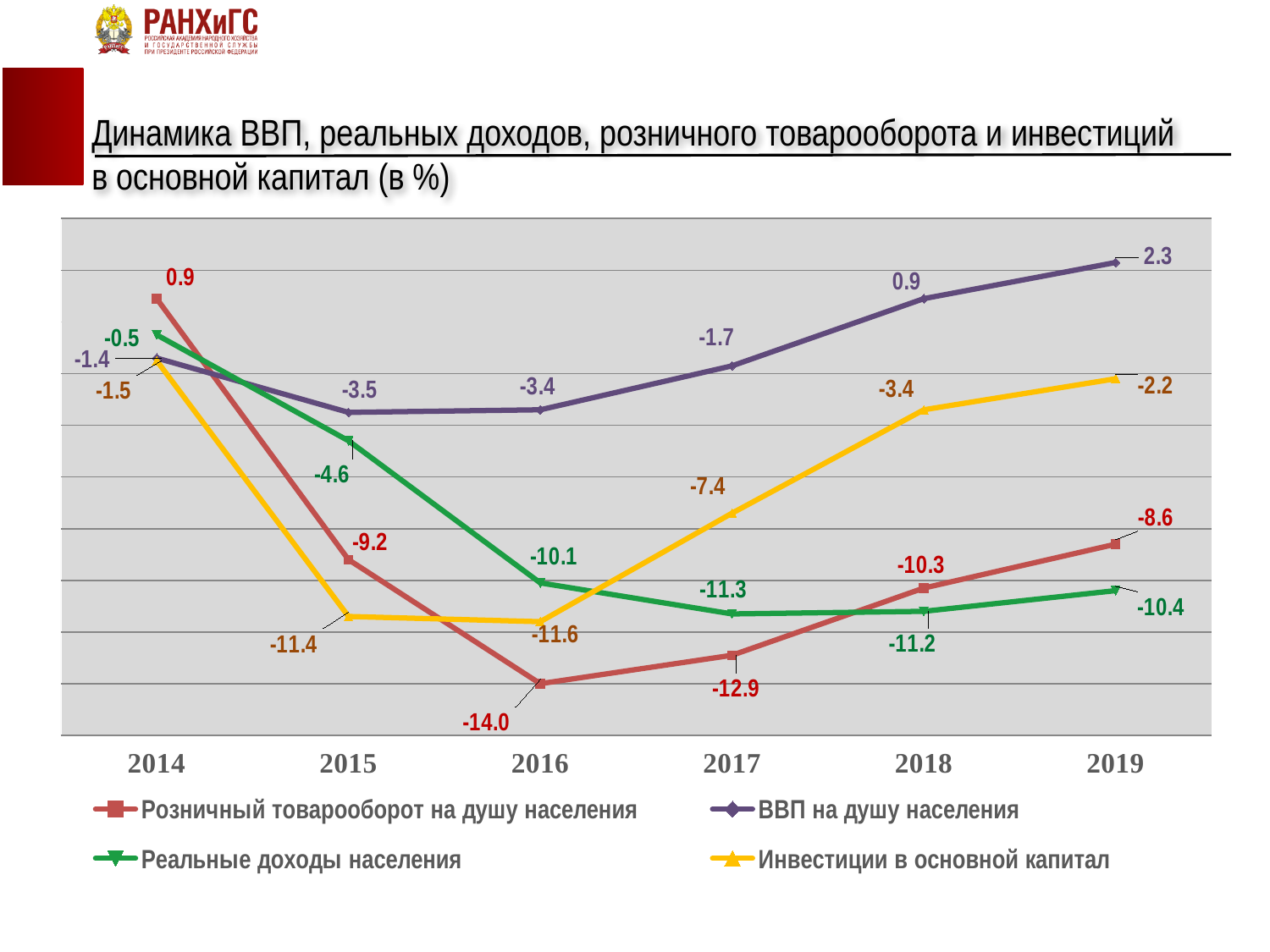
How many series does the legend list? 4 Does the value for Инвестиции в основной капитал rise or fall from 2016 to 2019? Rise What is the difference between the 2019 and 2014 values for ВВП на душу населения? 3.7 What is the value for Розничный товарооборот на душу населения in 2016? -14.0 Which series has the higher value in 2018: Инвестиции в основной капитал or Реальные доходы населения? Инвестиции в основной капитал What is the value for Реальные доходы населения in 2017? -11.3 What is the value for ВВП на душу населения in 2019? 2.3 How many years are shown on the x axis? 6 In which year is the value for ВВП на душу населения highest? 2019 In which year is the value for Розничный товарооборот на душу населения lowest? 2016 What is the value for Инвестиции в основной капитал in 2015? -11.4 What kind of chart is shown on the slide? Line chart